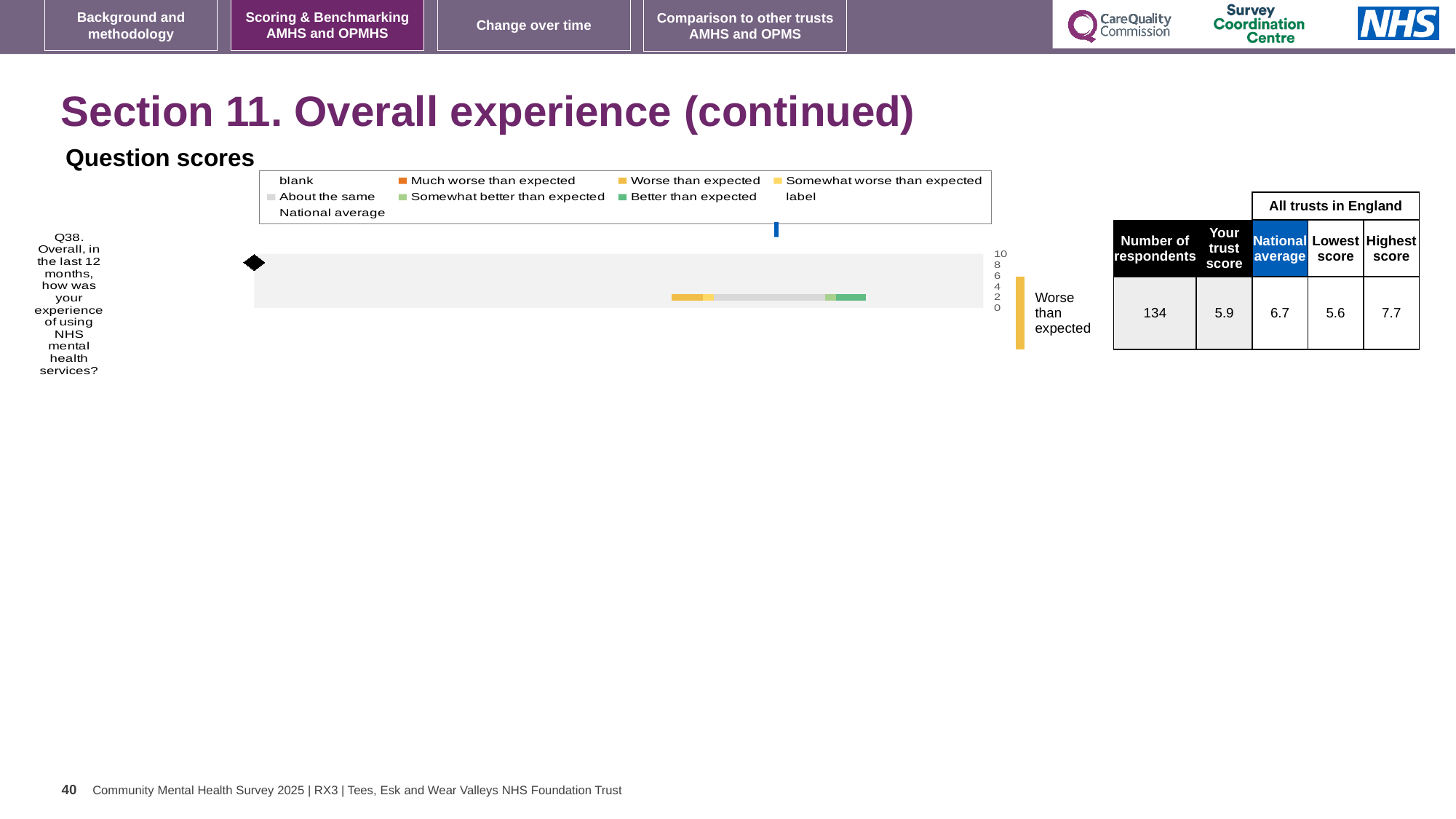
What is the highest score among all trusts in England for Q38? 7.7 What is the difference between the highest and lowest scores for Q38 across all trusts in England? 2.1 What is the highest tick value shown on the chart's score axis? 10 Which is larger for Q38: the trust's score or the national average? National average What is the trust's score for Q38 (Overall, in the last 12 months, how was your experience of using NHS mental health services?)? 5.9 What benchmark category label is shown next to the Q38 bar? Worse than expected How many survey questions are plotted in the Question scores chart? 1 What is the national average score for Q38? 6.7 How many respondents answered Q38? 134 What is the lowest score among all trusts in England for Q38? 5.6 What kind of chart is used to show the Q38 question score? bar chart By how much is the national average higher than the trust's score for Q38? 0.8